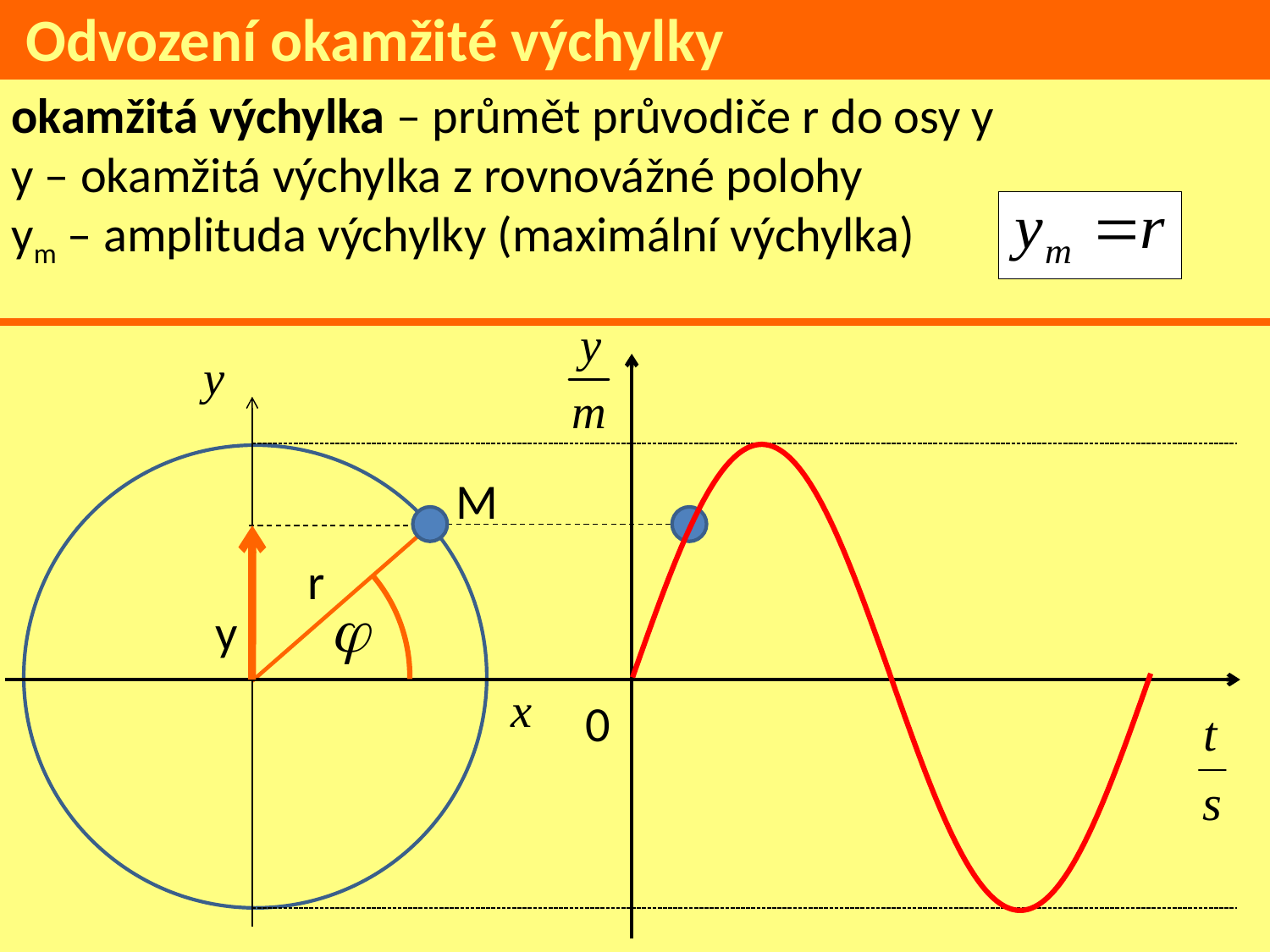
What is the label of the horizontal axis of the right-hand graph? t/s What value is marked at the origin of the right-hand graph? 0 On the right-hand graph, does the red curve rise or fall immediately after t = 0? rise How many curves are plotted on the right-hand graph? 1 What kind of chart is the graph on the right side of the slide? line chart What is the label of the vertical axis of the right-hand graph? y/m